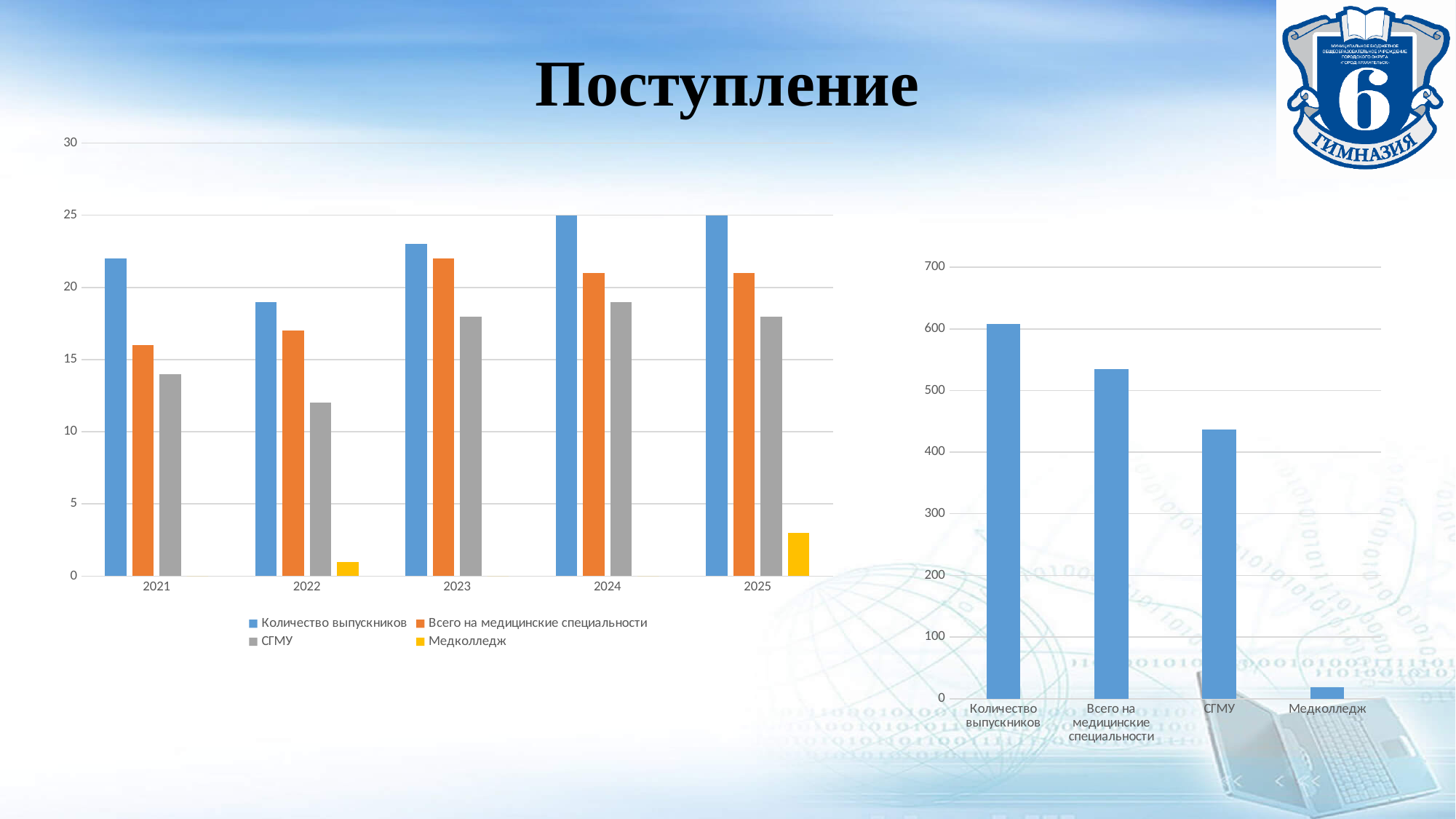
In the left chart, which is larger: Количество выпускников in 2021 or in 2022? 2021 In the right chart, which category has the highest value? Количество выпускников In the left chart, is the value for СГМУ in 2022 greater or less than 15? less How many years are shown on the x axis of the left chart? 5 In the right chart, is the value for СГМУ greater or less than 400? greater In the left chart, which year has the lowest value for Количество выпускников? 2022 How many series does the legend of the left chart list? 4 In the left chart, is the value for Количество выпускников in 2021 greater or less than 20? greater In the right chart, which category has the lowest value? Медколледж What kind of chart is the left chart on the slide? bar chart In the left chart, which year has the lowest value for СГМУ? 2022 In the left chart, does the value for Количество выпускников rise or fall from 2022 to 2024? rise